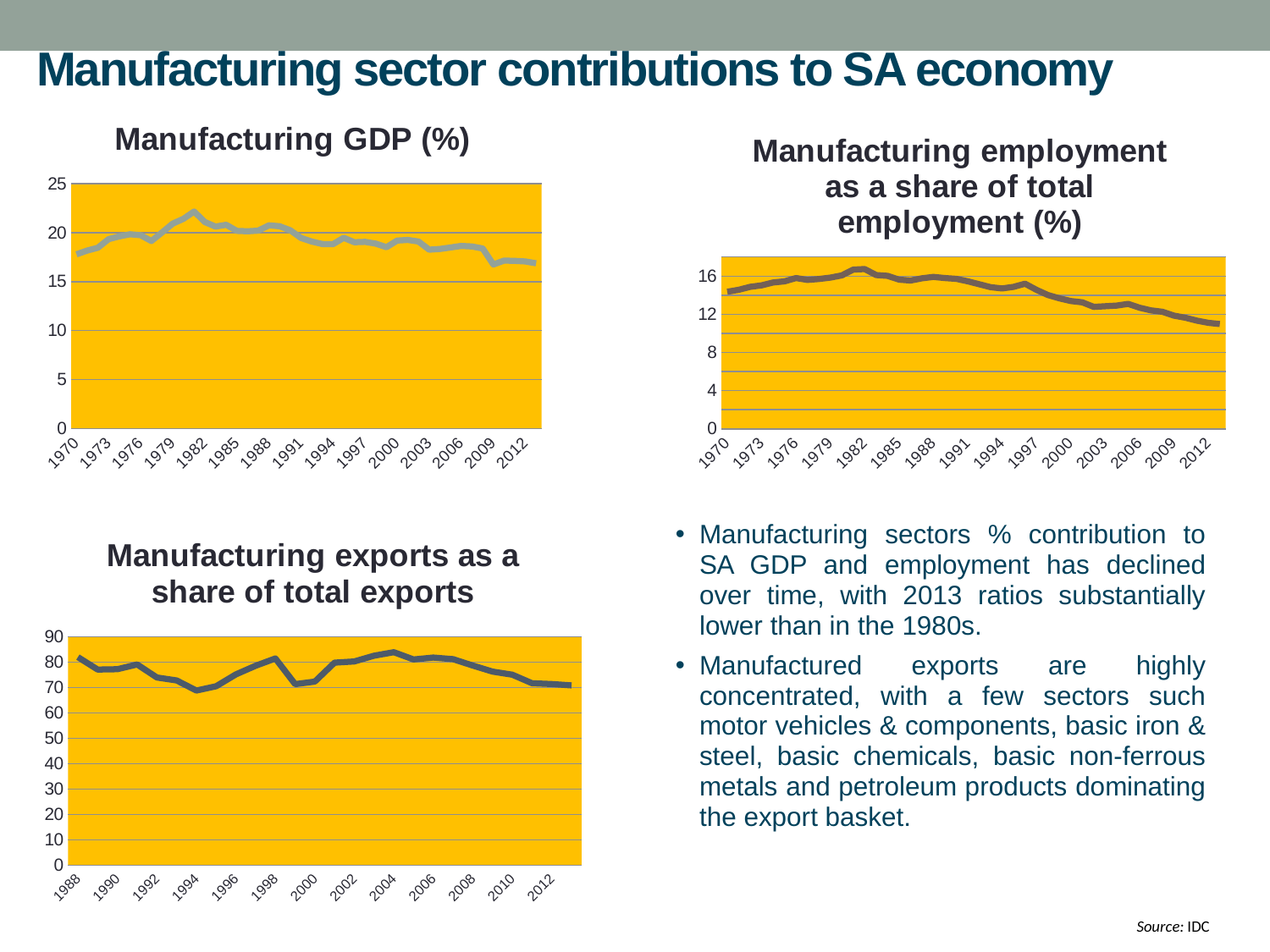
In the Manufacturing exports as a share of total exports chart, is the value for 2012 greater or less than 80? less In the Manufacturing exports as a share of total exports chart, is the value for 1994 greater or less than 80? less What is the first year shown on the x axis of the Manufacturing exports as a share of total exports chart? 1988 What is the title of the chart in the top right of the slide? Manufacturing employment as a share of total employment (%) In the Manufacturing GDP (%) chart, do the values overall rise or fall from 1970 to 2012? fall What kind of chart is the Manufacturing GDP (%) chart? line chart In the Manufacturing employment as a share of total employment (%) chart, is the value for 2012 greater or less than 12? less In the Manufacturing employment as a share of total employment (%) chart, do the values overall rise or fall between 1982 and 2012? fall